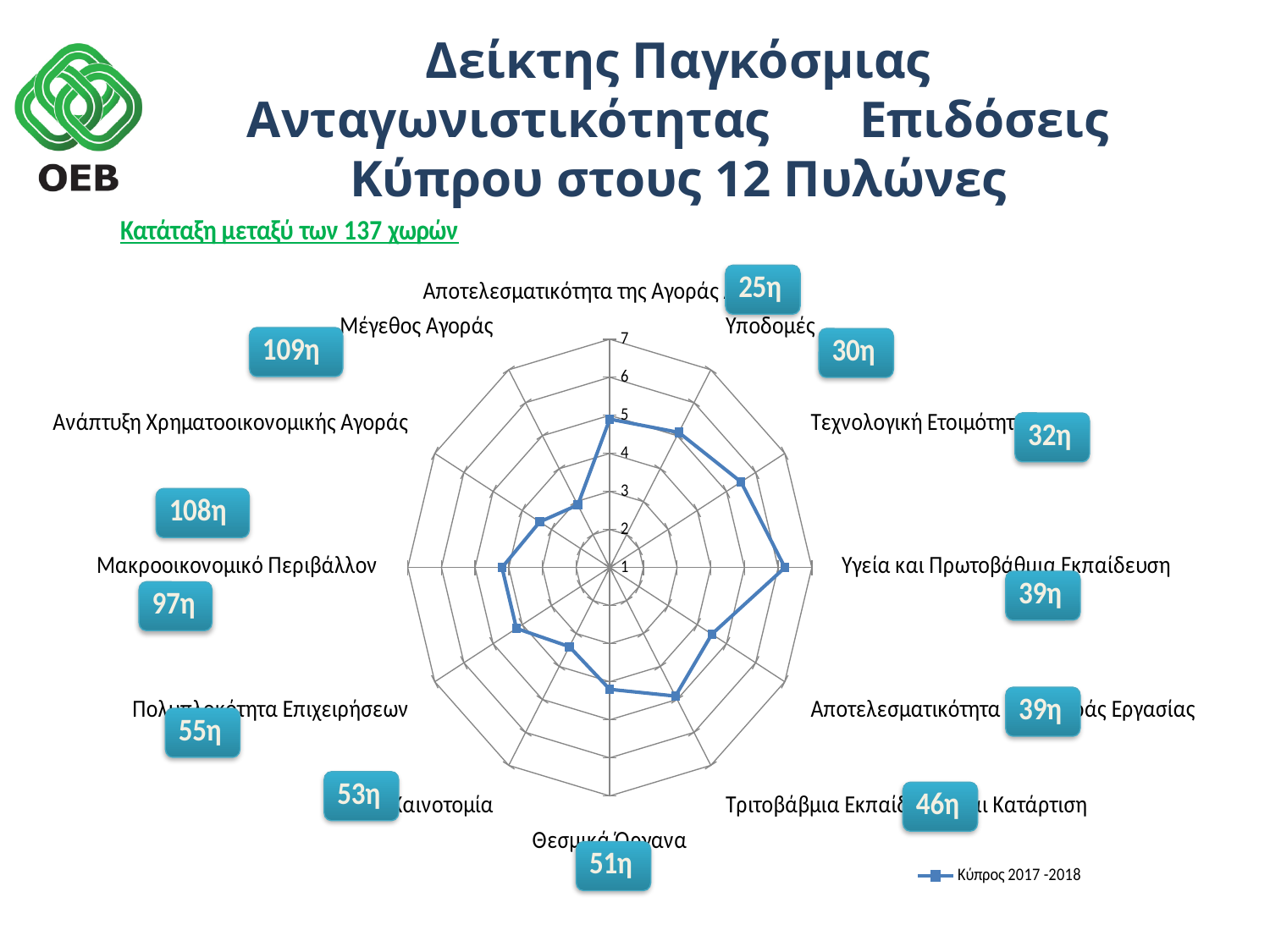
How many pillars (categories) are plotted on the radar chart? 12 How many series does the legend of the radar chart list? 1 What is the name of the series shown in the legend of the radar chart? Κύπρος 2017 -2018 Which has the larger value on the radar chart, Υγεία και Πρωτοβάθμια Εκπαίδευση or Μέγεθος Αγοράς? Υγεία και Πρωτοβάθμια Εκπαίδευση Which pillar has the highest value on the radar chart? Υγεία και Πρωτοβάθμια Εκπαίδευση What kind of chart is shown on the slide? Radar chart What is the highest value shown on the radial axis of the radar chart? 7 Which has the larger value on the radar chart, Υποδομές or Καινοτομία? Υποδομές Is the value for Τεχνολογική Ετοιμότητα greater or less than 4? greater